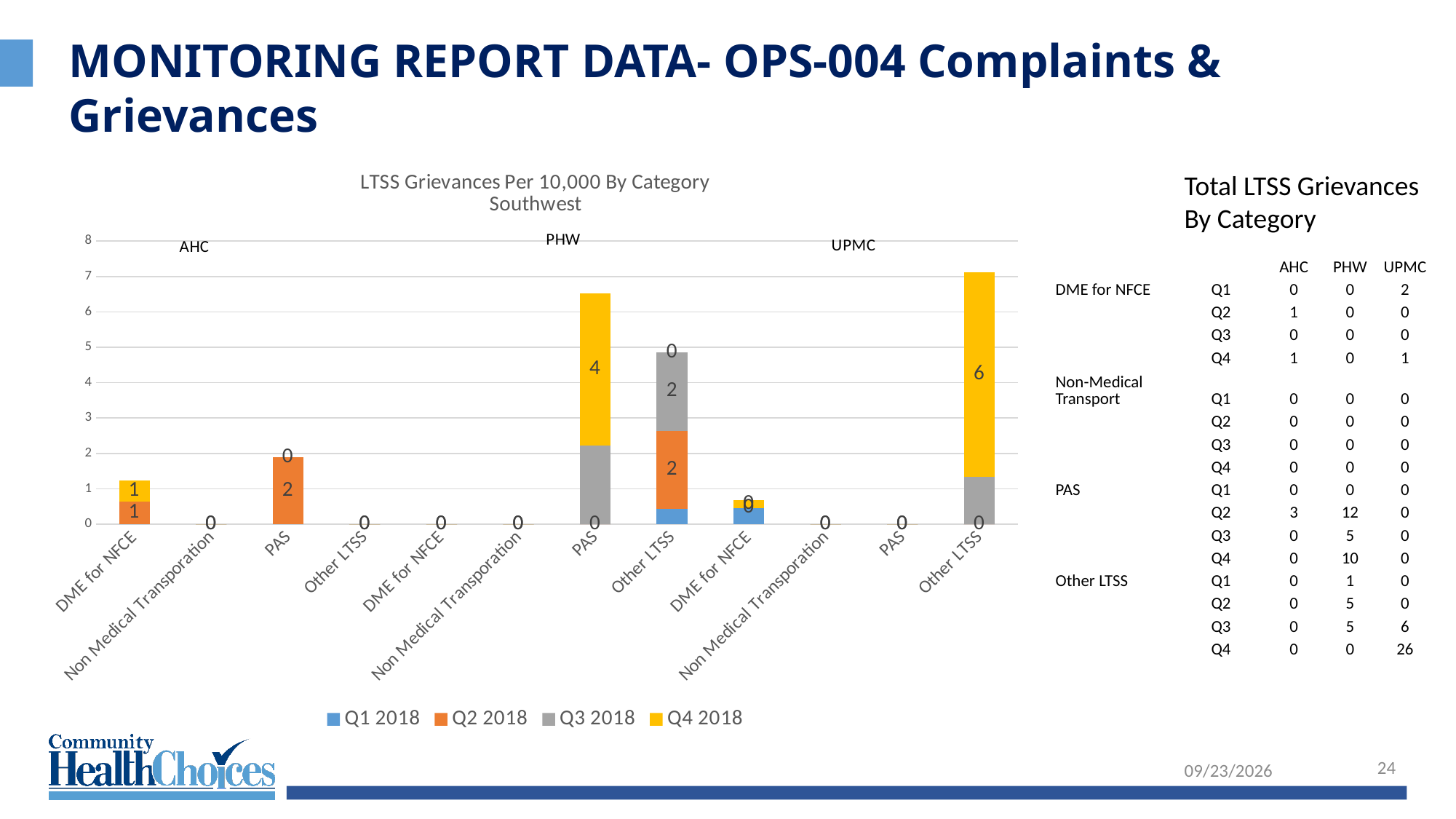
Which stacked bar is taller: PAS under AHC or PAS under PHW? PAS under PHW What kind of chart is shown on the slide? Stacked bar chart Is the stacked bar for PAS under PHW greater or less than 6? greater What data label is printed on the Q4 2018 segment of the PAS bar under PHW? 4 What data label is printed on the Q2 2018 segment of the PAS bar under AHC? 2 Is the stacked bar for Other LTSS under UPMC greater or less than 6? greater What is the title of the chart? LTSS Grievances Per 10,000 By Category Southwest How many category bars are shown along the x axis of the chart? 12 What data label is printed on the Q4 2018 segment of the Other LTSS bar under UPMC? 6 How many series does the chart legend list? 4 Which category has the tallest stacked bar in the chart? Other LTSS (UPMC)